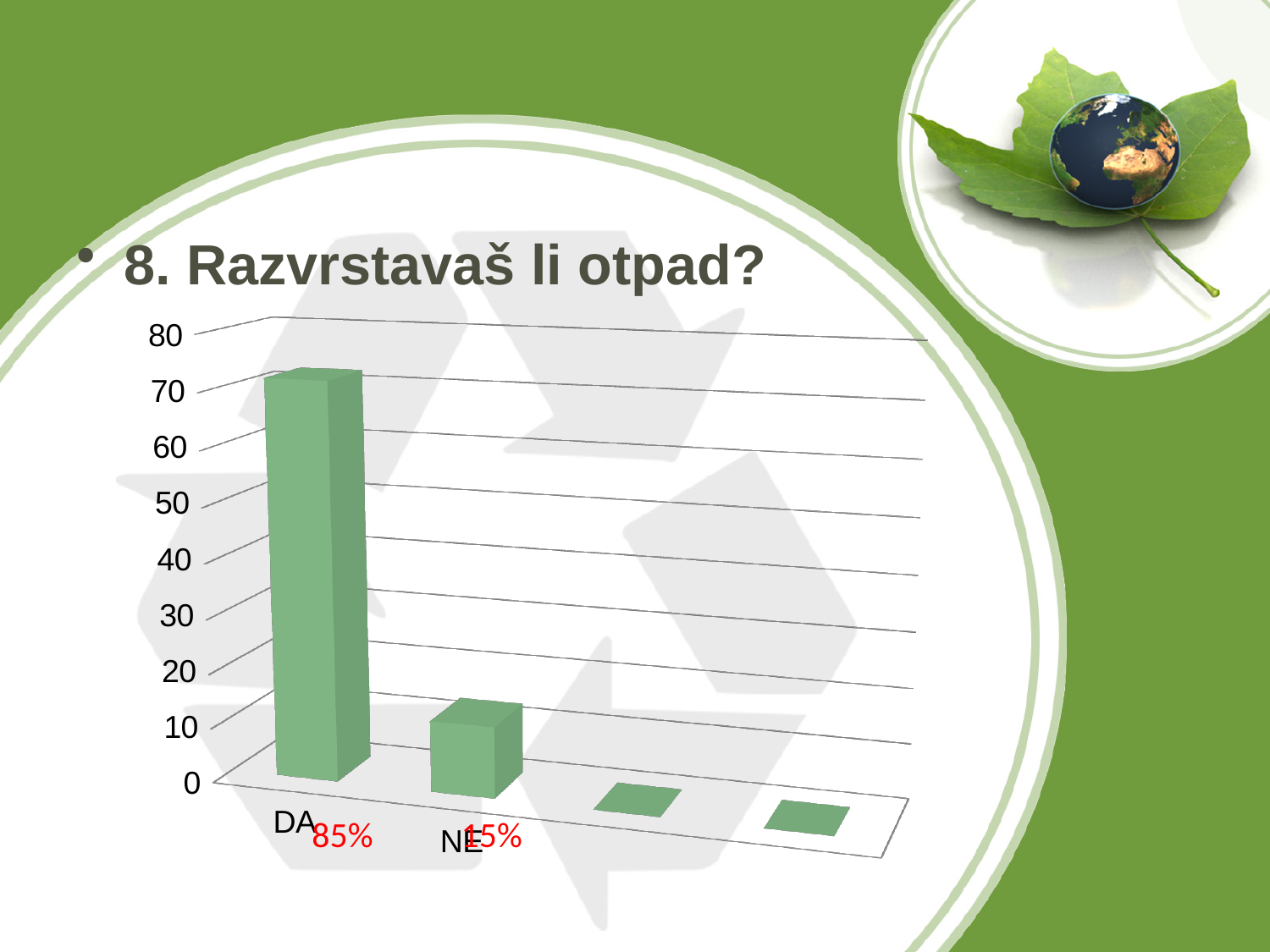
Do the bar values rise or fall from DA to NE? fall Is the value for NE greater or less than 20? less What kind of chart is shown on the slide? bar chart Which labeled category has the shortest bar? NE How many labeled categories are on the x axis? 2 Is the value for DA greater or less than 60? greater What percentage is printed in red next to the DA category? 85% Is the value for DA greater or less than 80? less What is the title of the slide above the chart? 8. Razvrstavaš li otpad? What percentage is printed in red next to the NE category? 15% Which bar is taller, DA or NE? DA Which labeled category has the tallest bar? DA